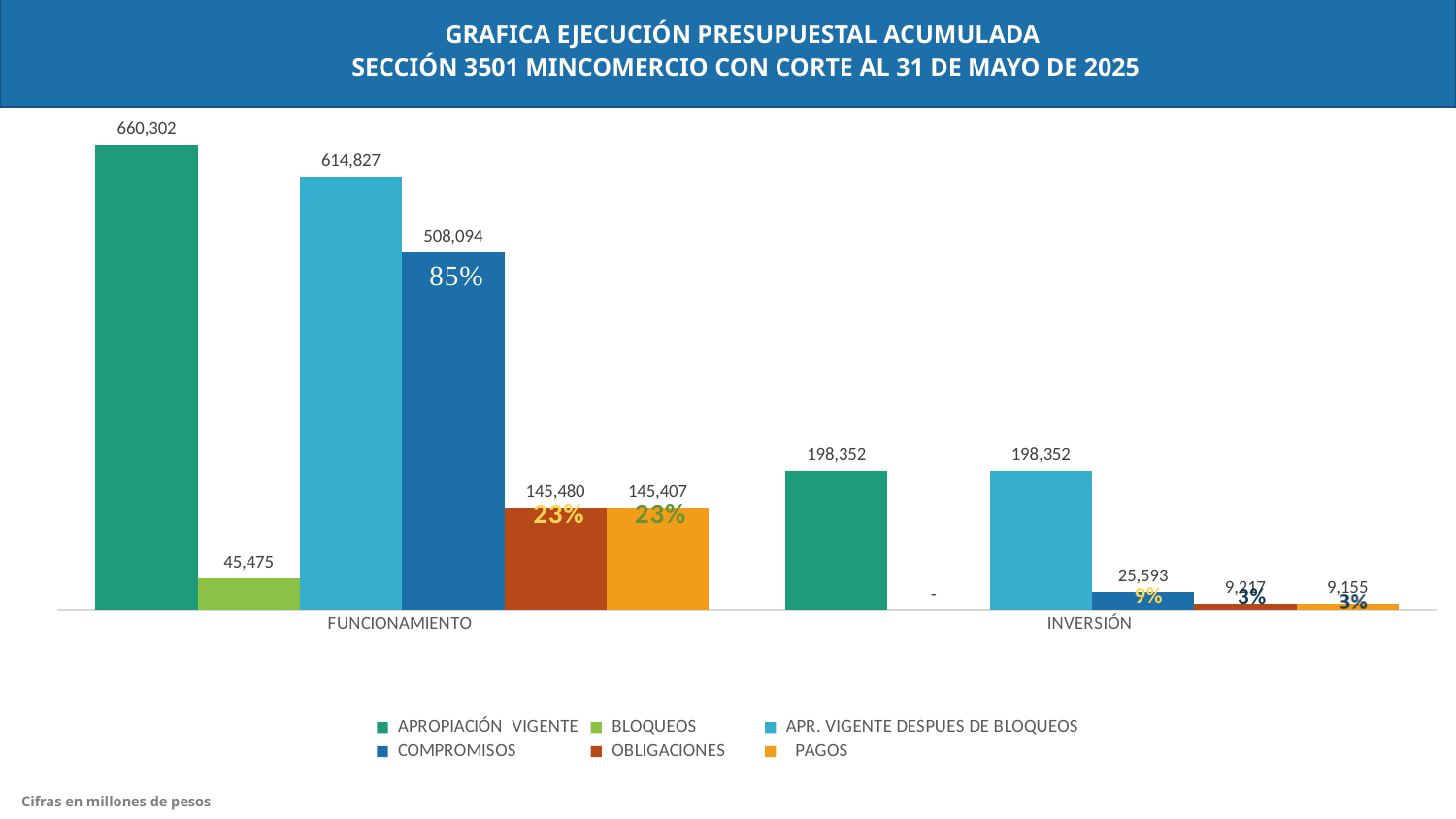
Which is larger, COMPROMISOS for FUNCIONAMIENTO or APROPIACIÓN VIGENTE for INVERSIÓN? COMPROMISOS for FUNCIONAMIENTO What is the value of APR. VIGENTE DESPUES DE BLOQUEOS for INVERSIÓN? 198,352 What is the value of COMPROMISOS for INVERSIÓN? 25,593 Which series has the highest value for FUNCIONAMIENTO? APROPIACIÓN VIGENTE What is the value of APROPIACIÓN VIGENTE for FUNCIONAMIENTO? 660,302 Which series has the lowest value for FUNCIONAMIENTO? BLOQUEOS How many categories are shown on the x axis? 2 What is the difference between APROPIACIÓN VIGENTE and APR. VIGENTE DESPUES DE BLOQUEOS for FUNCIONAMIENTO? 45,475 What is the value of BLOQUEOS for FUNCIONAMIENTO? 45,475 What kind of chart is shown on the slide? Bar chart What is the difference between OBLIGACIONES and PAGOS for INVERSIÓN? 62 How many series does the legend list? 6